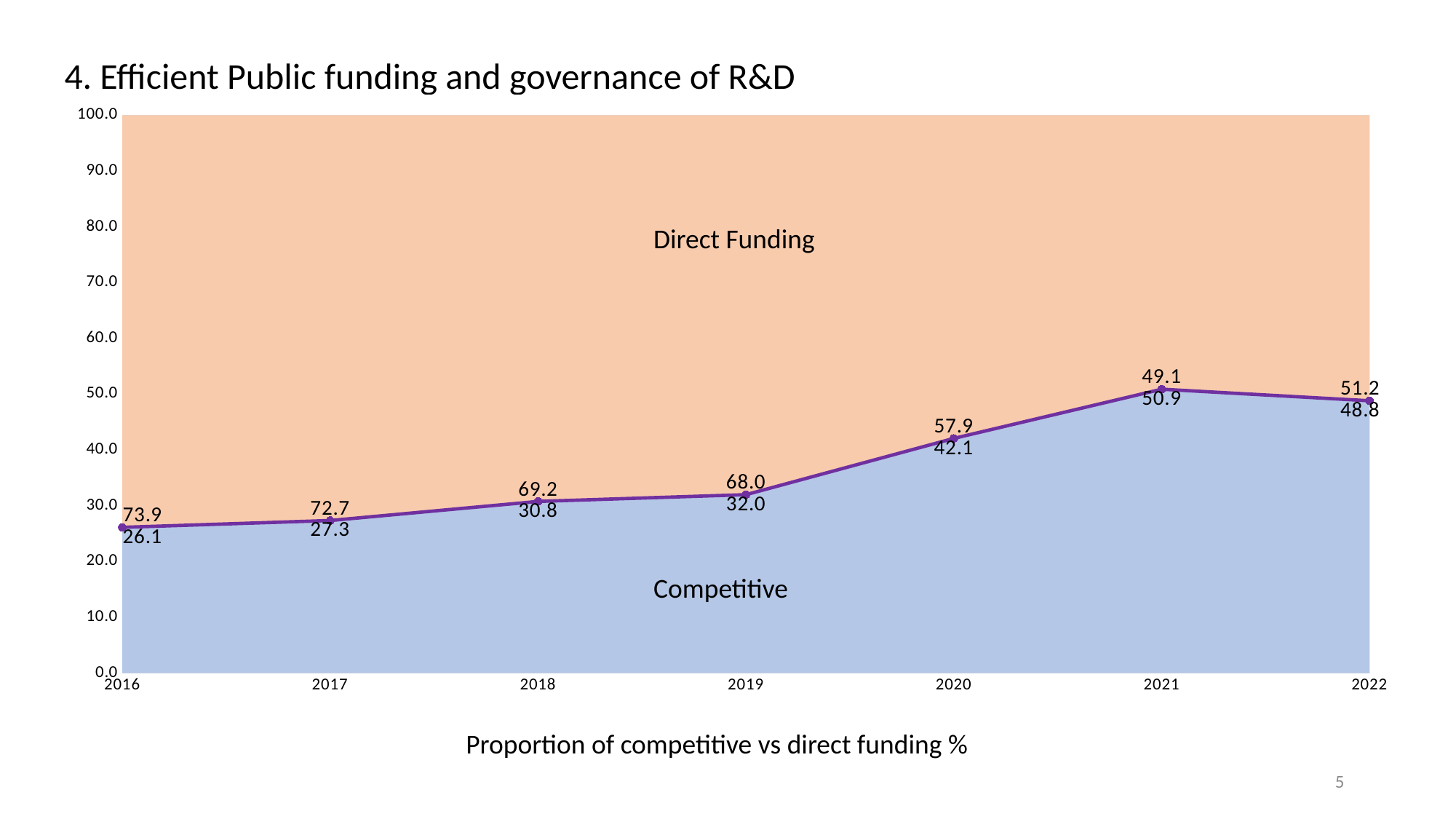
What is the difference between the Direct Funding and Competitive proportions in 2019? 36.0 What kind of chart is shown on the slide? area chart What is the caption below the chart? Proportion of competitive vs direct funding % What is the Direct Funding proportion in 2020? 57.9 In which year is the Direct Funding proportion lowest? 2021 In which year is the Competitive funding proportion highest? 2021 Does the Competitive funding proportion generally rise or fall from 2016 to 2021? rise Which is larger in 2022, the Competitive proportion or the Direct Funding proportion? Direct Funding What is the Competitive funding proportion in 2016? 26.1 What is the Competitive funding proportion in 2022? 48.8 Is the Competitive funding proportion in 2021 greater or less than 50.0? greater How many years are shown on the x axis? 7